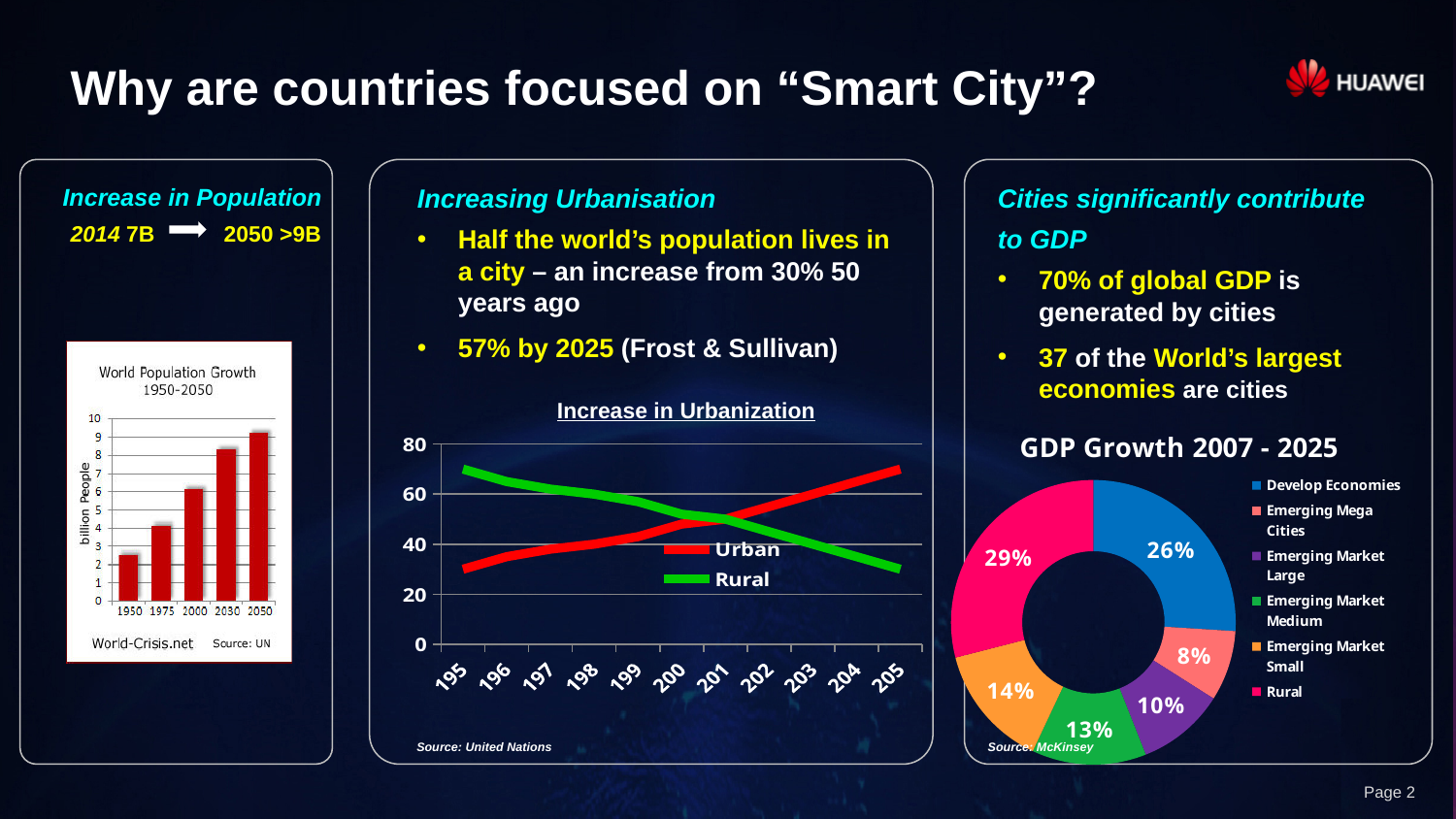
In the GDP Growth 2007 - 2025 chart, what share is shown for Rural? 29% In the GDP Growth 2007 - 2025 chart, what share is shown for Develop Economies? 26% In the GDP Growth 2007 - 2025 chart, which category has the largest share? Rural In the GDP Growth 2007 - 2025 chart, what share is shown for Emerging Market Medium? 13% In the World Population Growth 1950-2050 chart, which year has the lowest bar? 1950 In the GDP Growth 2007 - 2025 chart, which category has the smallest share? Emerging Mega Cities In the Increase in Urbanization chart, how many series does the legend list? 2 In the Increase in Urbanization chart, does the Urban line rise or fall along the x axis? Rises How many categories does the legend of the GDP Growth 2007 - 2025 chart list? 6 In the GDP Growth 2007 - 2025 chart, what is the difference between the Emerging Market Small share and the Emerging Market Large share? 4% In the World Population Growth 1950-2050 chart, is the value for 2050 greater or less than 8 billion people? greater What kind of chart is the GDP Growth 2007 - 2025 chart? Doughnut chart